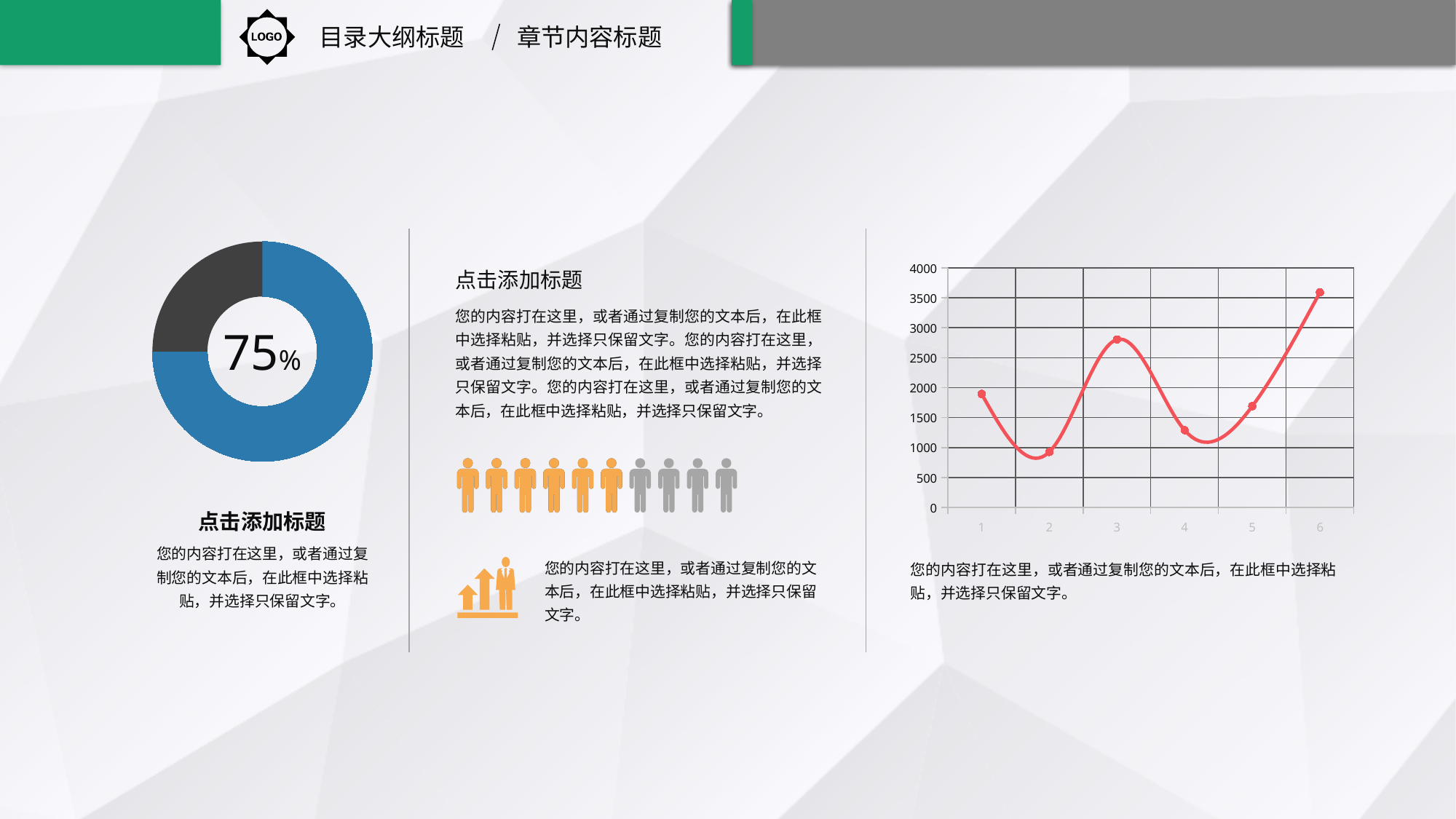
On the right line chart, is the value at category 3 greater or less than 2500? greater On the left donut chart, what share does the blue segment represent? 75% On the left donut chart, what percentage is printed in the centre? 75% What kind of chart is shown on the right side of the slide? Line chart On the right line chart, is the value at category 2 greater or less than 1000? less On the right line chart, how many data points are plotted? 6 On the right line chart, which x-axis category has the highest value? 6 On the right line chart, do the values rise or fall from category 4 to category 6? rise On the right line chart, is the value at category 6 greater or less than 3000? greater What kind of chart is shown on the left side of the slide? Donut (pie) chart On the right line chart, which x-axis category has the lowest value? 2 On the right line chart, which has the larger value, category 3 or category 5? 3